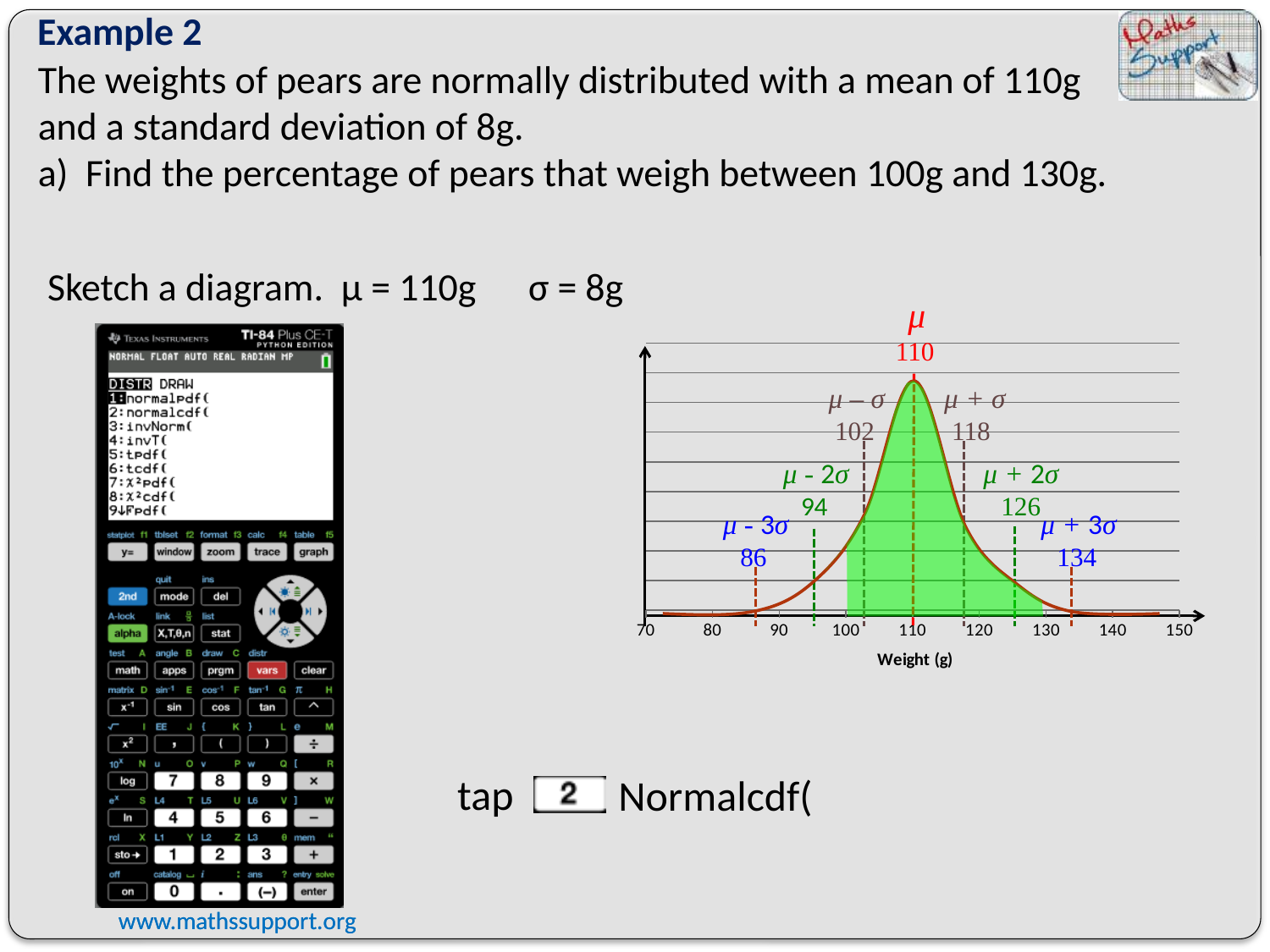
Between which two x-axis values is the green shaded region under the curve? 100 and 130 What is the x-axis title of the chart? Weight (g) What is the highest tick value shown on the x-axis of the chart? 150 What value is labelled at μ + 3σ on the chart? 134 What value is labelled at μ + 2σ on the chart? 126 What value is labelled at μ + σ on the chart? 118 What is the difference between the values labelled at μ + 3σ and μ − 3σ on the chart? 48 What value is labelled at μ − 2σ on the chart? 94 What is the lowest tick value shown on the x-axis of the chart? 70 What value is labelled at μ − σ on the chart? 102 What value is labelled at the mean (μ) on the chart? 110 What value is labelled at μ − 3σ on the chart? 86